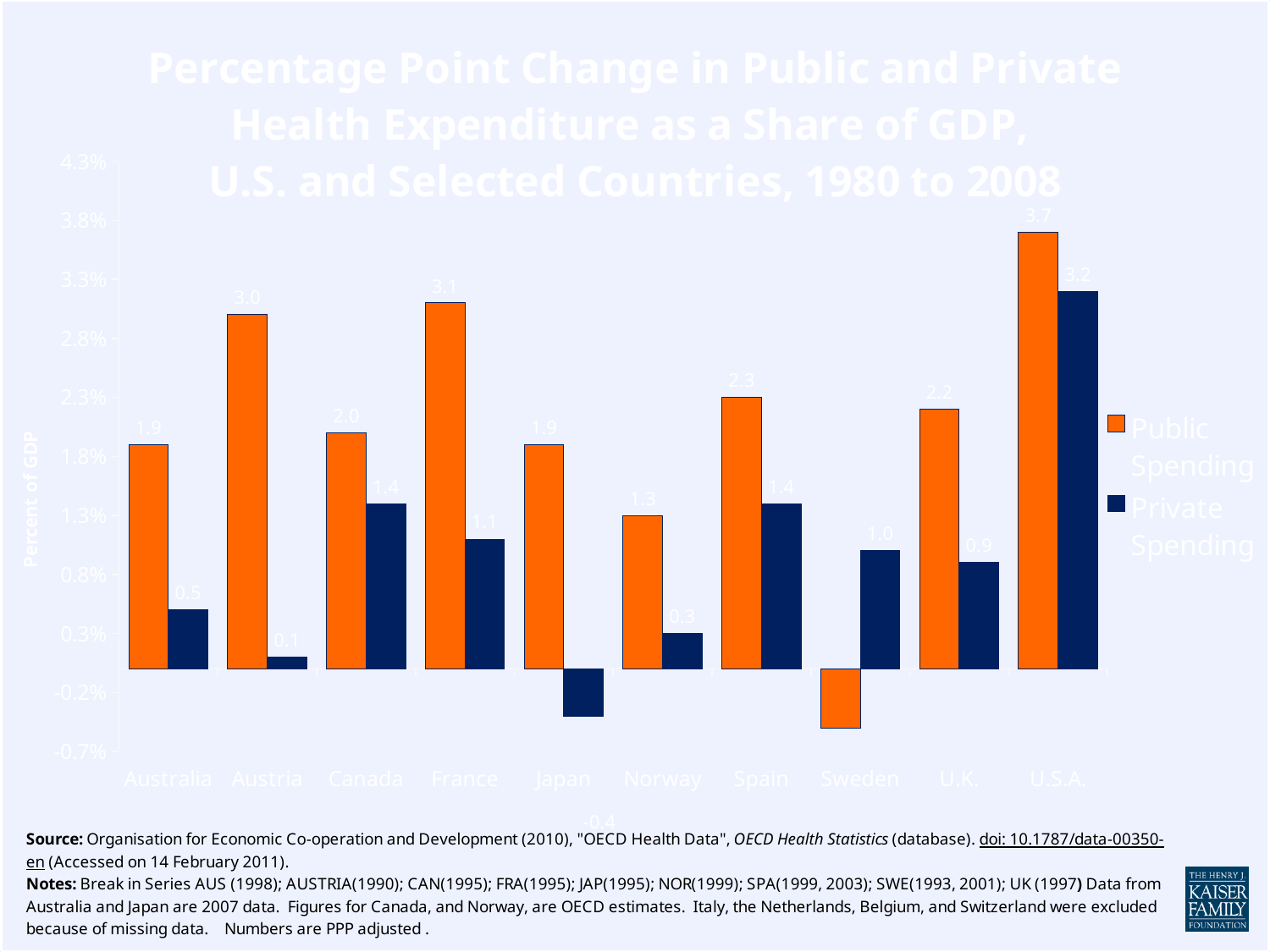
Is the Public Spending value for Sweden greater or less than 0.3%? less How many countries are shown on the x axis? 10 Which country has the highest Private Spending value? U.S.A. What is the Private Spending value for Canada? 1.4 Which country has the lowest Public Spending value? Sweden What is the Public Spending value for the U.S.A.? 3.7 Which is larger, the Public Spending value for Spain or the Public Spending value for the U.K.? Spain What is the difference between the Public Spending and Private Spending values for Austria? 2.9 What is the Public Spending value for France? 3.1 How many series does the legend list? 2 What is the label of the y axis? Percent of GDP What kind of chart is shown on the slide? bar chart